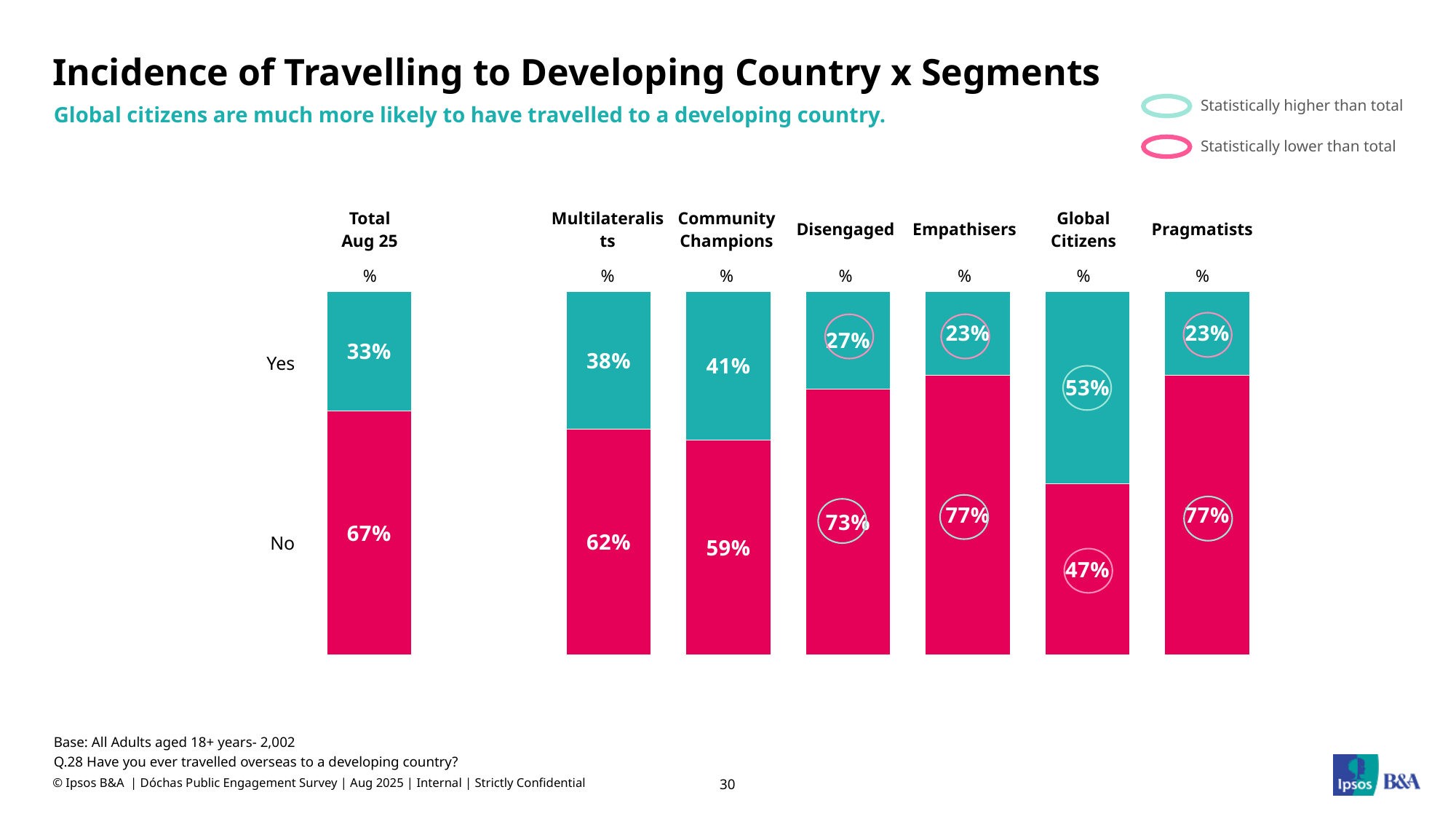
What type of chart is shown on the slide? Stacked bar chart What is the No value for Multilateralists? 62% What is the total of the Yes and No values for Empathisers? 100% Which is larger, the Yes value for Disengaged or the Yes value for Multilateralists? Multilateralists What is the No value for Global Citizens? 47% What is the Yes value for Community Champions? 41% According to the legend, what does a pink circle around a value indicate? Statistically lower than total What percentage of the Total Aug 25 group answered Yes to having travelled to a developing country? 33% Which segment has the lowest No value? Global Citizens Which segment has the highest Yes value? Global Citizens How many segment bars are shown in addition to the Total Aug 25 bar? 6 What is the difference between the Yes value for Global Citizens and the Yes value for Total Aug 25? 20%